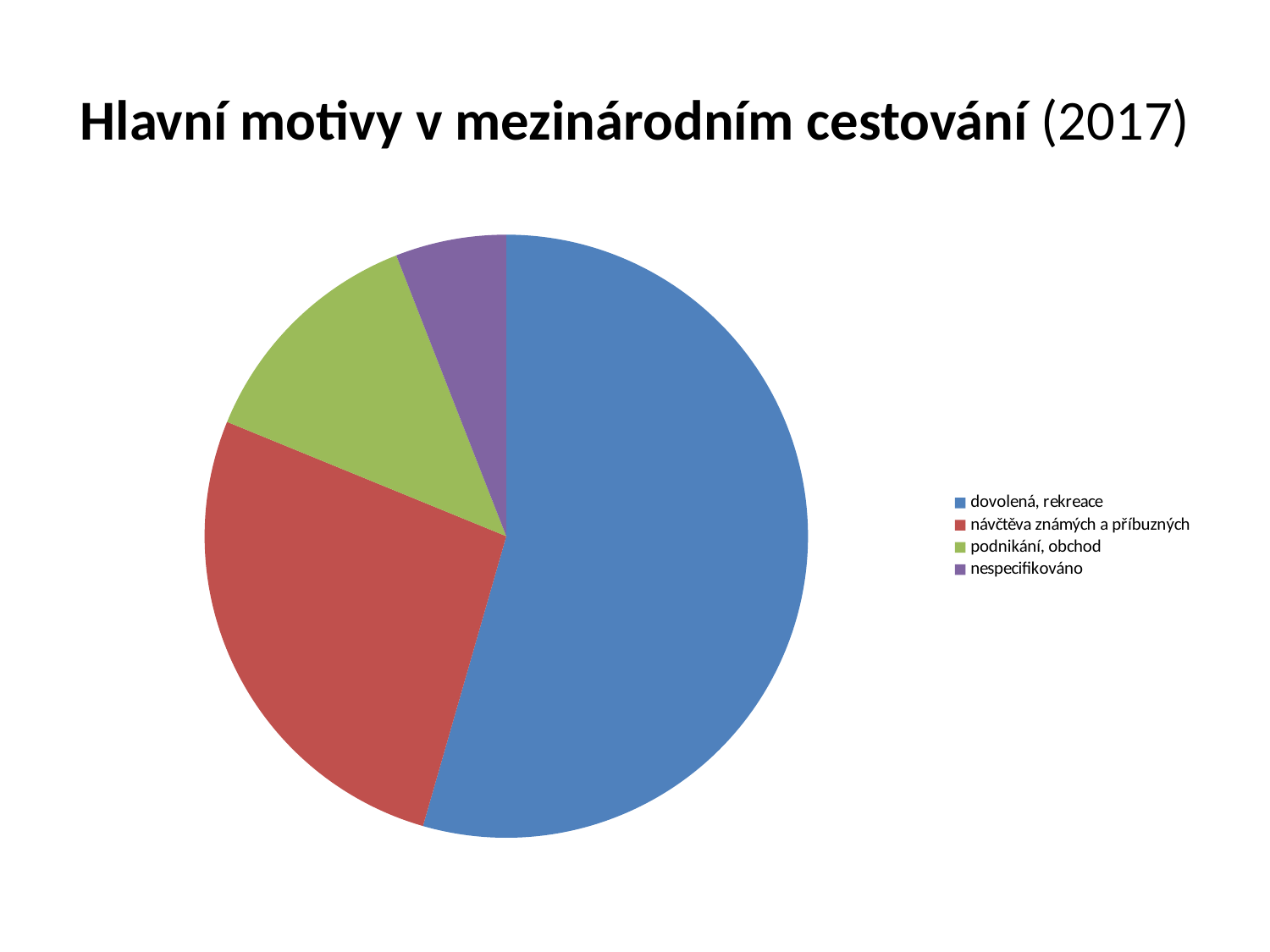
Which category has the largest slice of the pie? dovolená, rekreace Does the slice for dovolená, rekreace take up more or less than half of the pie? more Which slice is larger: podnikání, obchod or nespecifikováno? podnikání, obchod What kind of chart is shown on the slide? pie chart Which slice is larger: návčtěva známých a příbuzných or podnikání, obchod? návčtěva známých a příbuzných What is the title of the slide's chart? Hlavní motivy v mezinárodním cestování (2017) Which slice is larger: dovolená, rekreace or návčtěva známých a příbuzných? dovolená, rekreace Which category has the smallest slice of the pie? nespecifikováno How many slices does the pie chart have? 4 What colour is the slice for podnikání, obchod? green